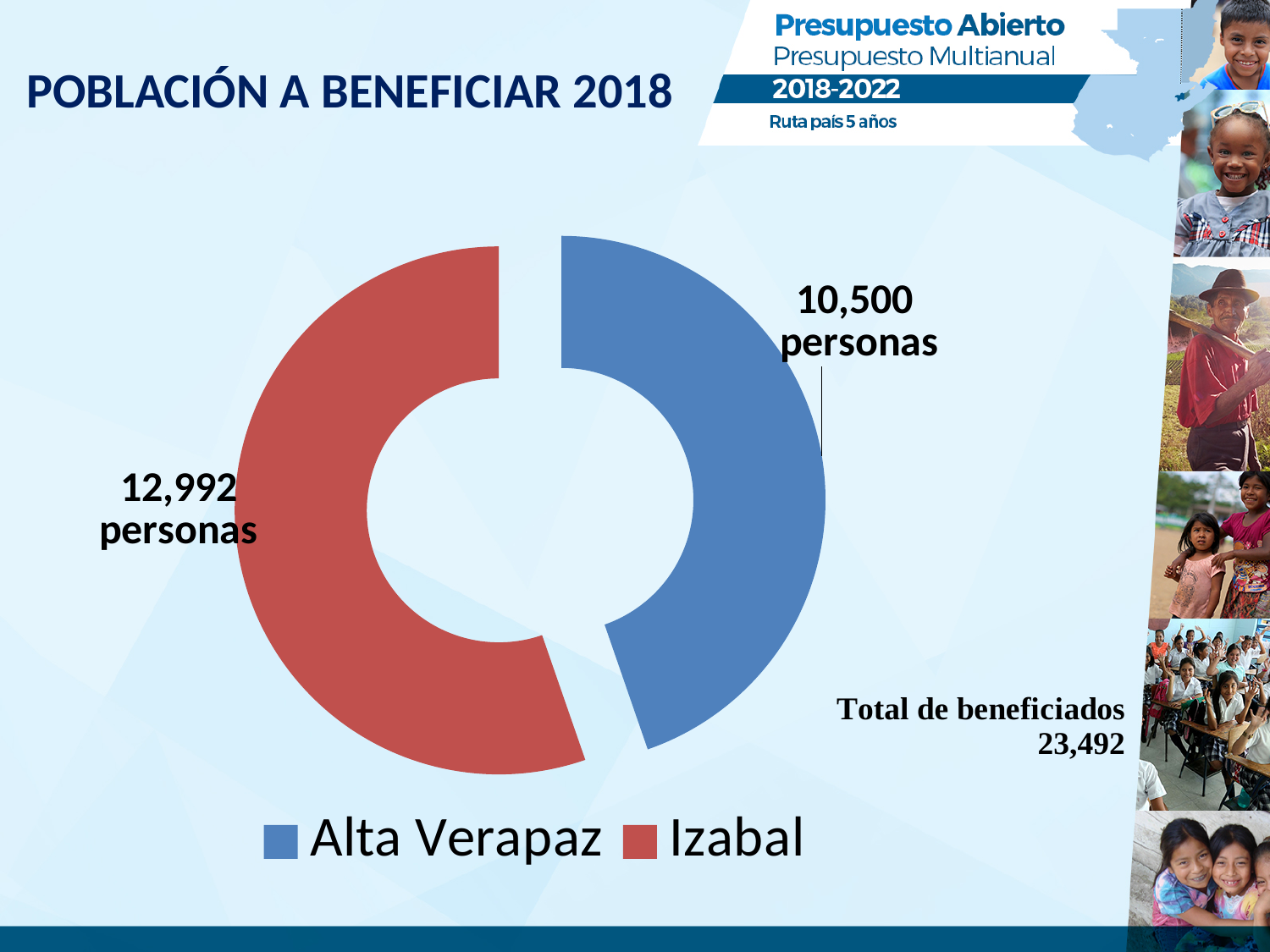
How many people are to benefit in Izabal? 12,992 personas How many categories does the chart show? 2 What is the title of the slide containing the chart? POBLACIÓN A BENEFICIAR 2018 Which department has the larger number of beneficiaries? Izabal What kind of chart is shown on the slide? doughnut chart Which department has the smaller number of beneficiaries? Alta Verapaz Which colour represents Izabal in the chart? red How many entries does the legend list? 2 What is the total number of beneficiaries shown on the slide? 23,492 What is the difference between the beneficiaries in Izabal and in Alta Verapaz? 2,492 Is the value for Alta Verapaz larger or smaller than the value for Izabal? smaller How many people are to benefit in Alta Verapaz? 10,500 personas